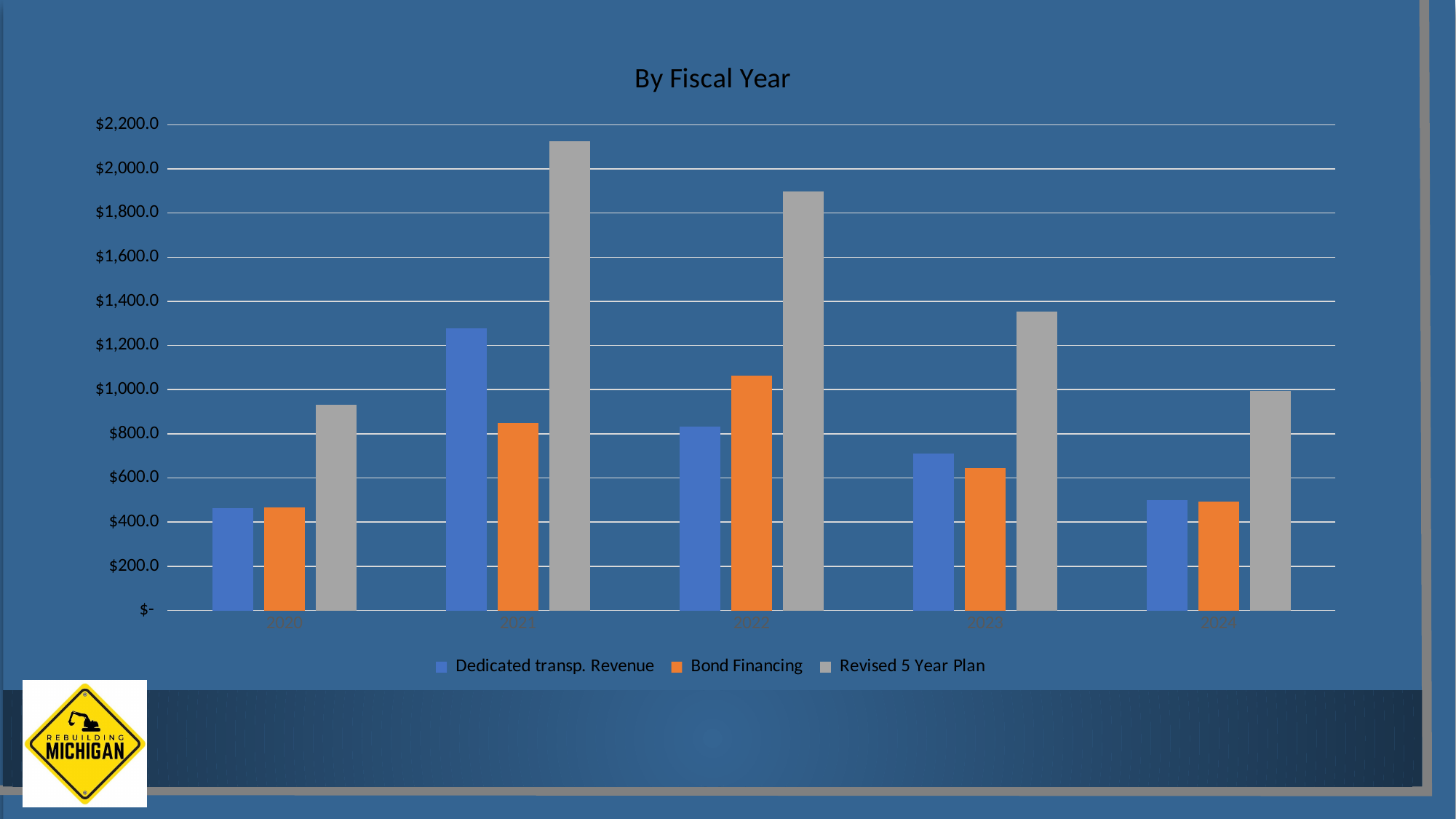
Is the Bond Financing value for 2022 greater or less than $1,000.0? greater What is the title of the chart? By Fiscal Year How many fiscal years are shown on the x axis? 5 Is the Revised 5 Year Plan value for 2021 greater or less than $2,000.0? greater What kind of chart is shown on the slide? Bar chart In which fiscal year is the Dedicated transp. Revenue value highest? 2021 Does the Revised 5 Year Plan value rise or fall from 2021 to 2024? Fall How many series does the legend list? 3 In which fiscal year is the Revised 5 Year Plan value highest? 2021 Is the Revised 5 Year Plan value for 2023 greater or less than $1,400.0? less In which fiscal year is the Bond Financing value highest? 2022 In 2021, which is larger: Dedicated transp. Revenue or Bond Financing? Dedicated transp. Revenue